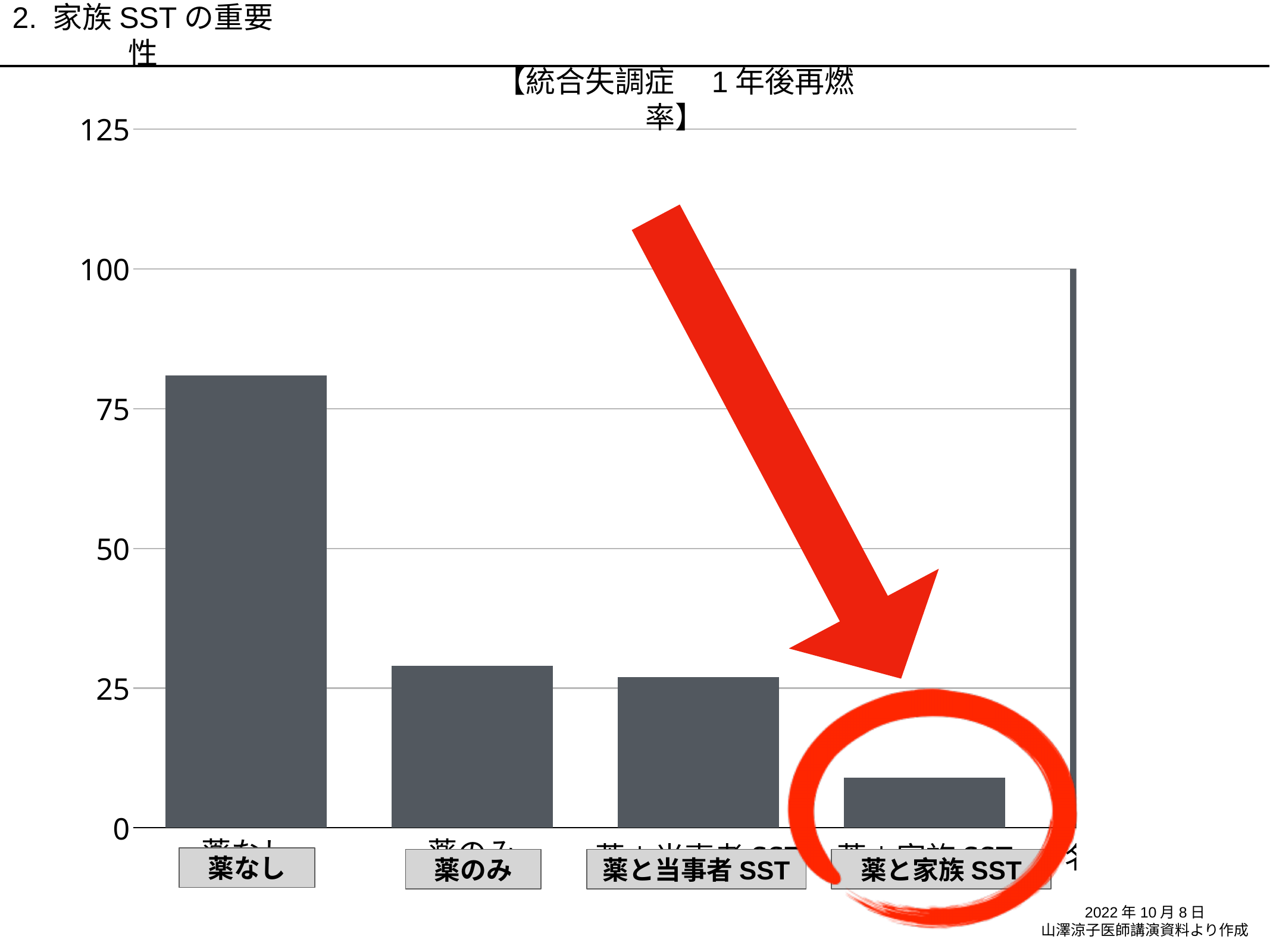
Which is larger, the value for 薬なし or the value for 薬と家族SST? 薬なし What kind of chart is shown on the slide? bar chart Is the value for 薬なし greater or less than 100? less What is the title of the chart? 【統合失調症 1年後再燃率】 Which is larger, the value for 薬のみ or the value for 薬と家族SST? 薬のみ Is the value for 薬と家族SST greater or less than 25? less Which category has the lowest value in the chart? 薬と家族SST Is the value for 薬と当事者SST greater or less than 50? less